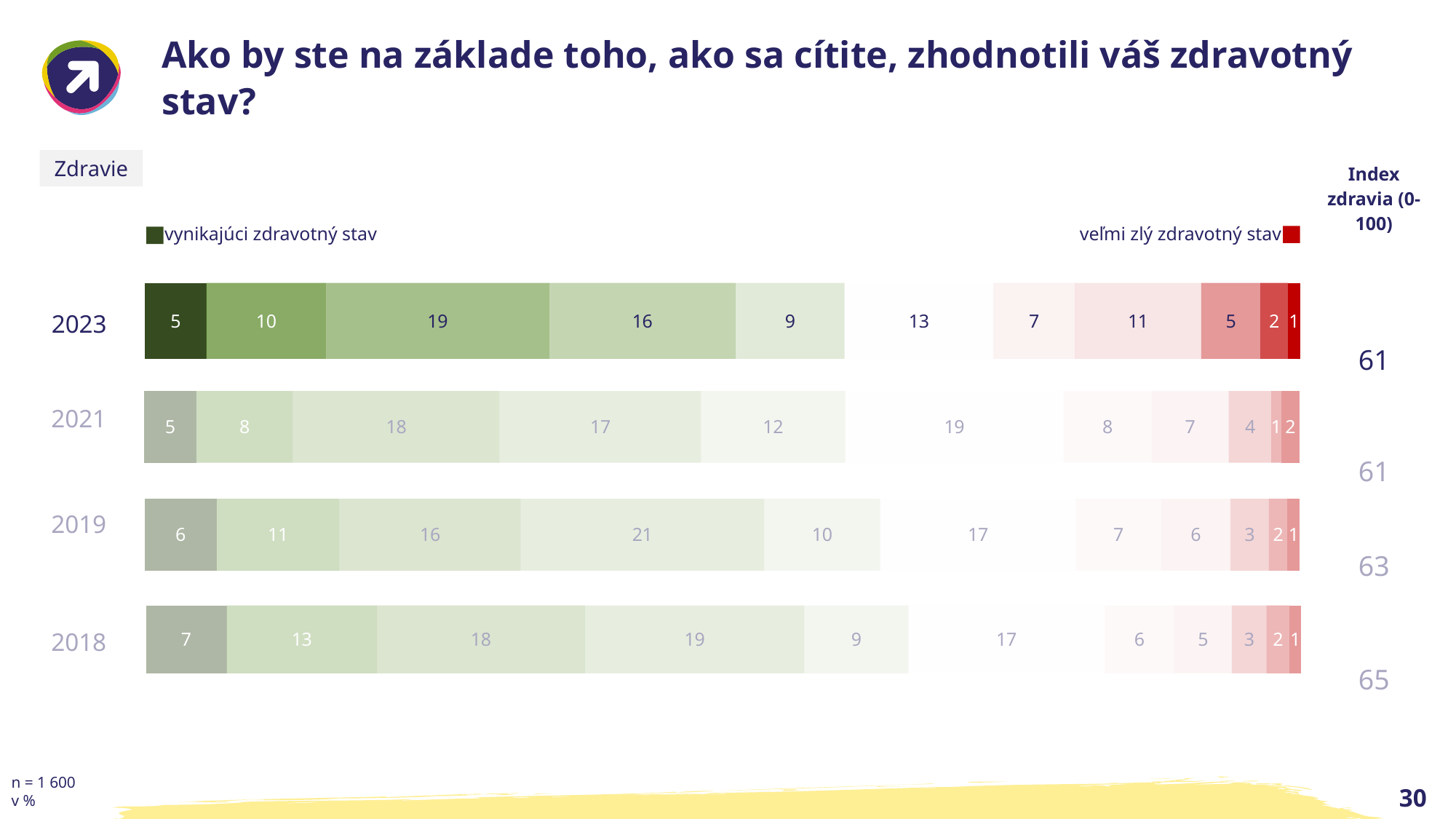
What is the value for 'vynikajúci zdravotný stav' in 2018? 7 Does the 'Index zdravia' rise or fall from 2018 to 2023? fall What is the largest segment value in the 2019 bar? 21 What kind of chart is shown on the slide? stacked bar chart How many years (bars) are shown in the chart? 4 Which year has the highest value for 'vynikajúci zdravotný stav'? 2018 What is the 'Index zdravia (0-100)' value for 2023? 61 What is the value for 'veľmi zlý zdravotný stav' in 2021? 2 What is the value for 'veľmi zlý zdravotný stav' in 2023? 1 Which year has the highest 'Index zdravia (0-100)' value? 2018 What is the value for 'vynikajúci zdravotný stav' in 2023? 5 What is the difference between the 'Index zdravia' values for 2018 and 2023? 4